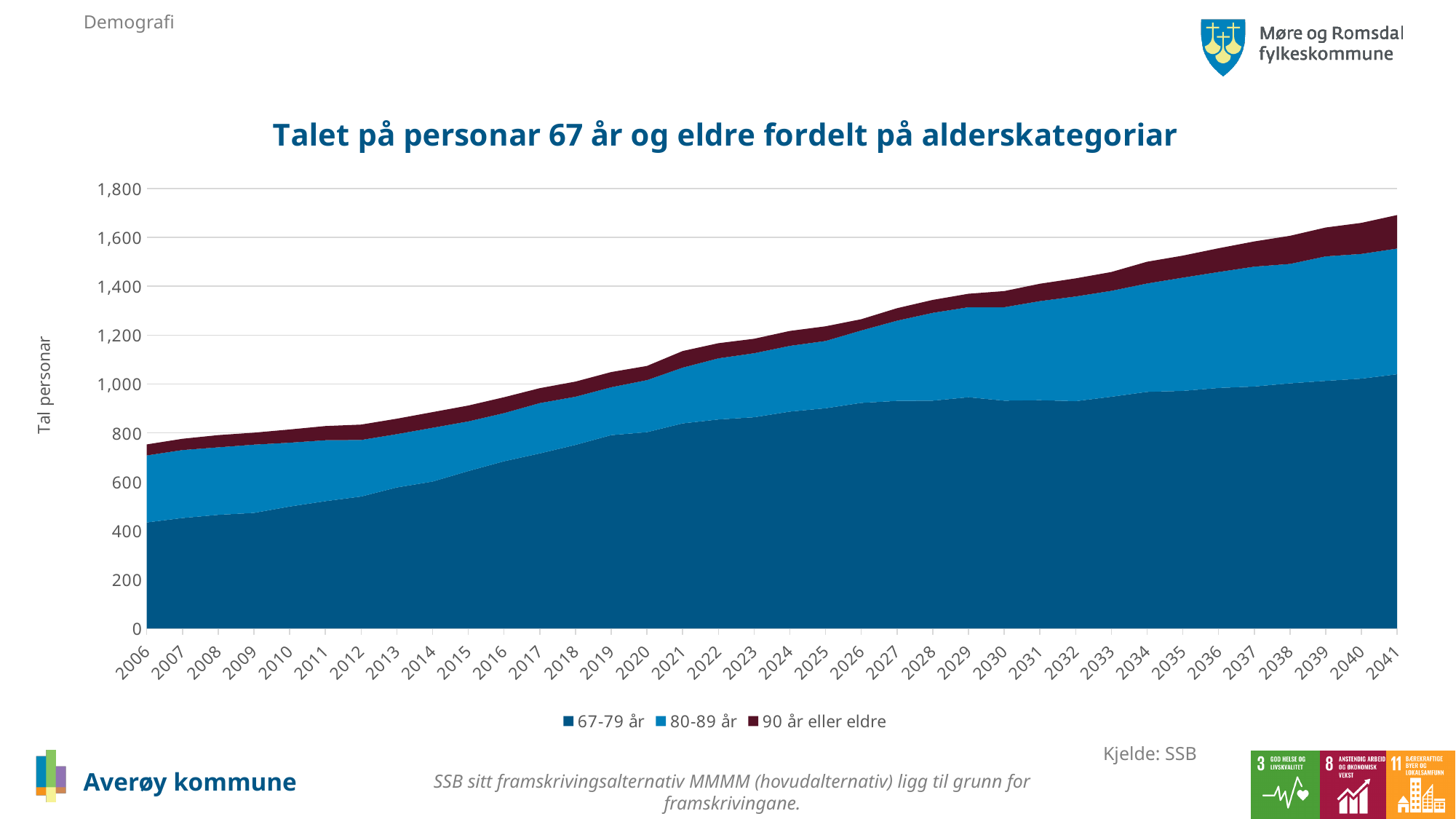
Which series is shown in the darkest (maroon) colour at the top of the stack? 90 år eller eldre What kind of chart is shown on the slide? Stacked area chart Is the total value for 2006 greater or less than 800? less How many years are shown along the x axis? 36 Which year has the larger value for the 67-79 år series, 2006 or 2041? 2041 How many series does the legend list? 3 Is the total value for 2041 greater or less than 1,600? greater Is the value for the 67-79 år series in 2006 greater or less than 400? greater Does the total number of persons 67 years and older rise or fall from 2006 to 2041? Rise What is the label on the y axis? Tal personar